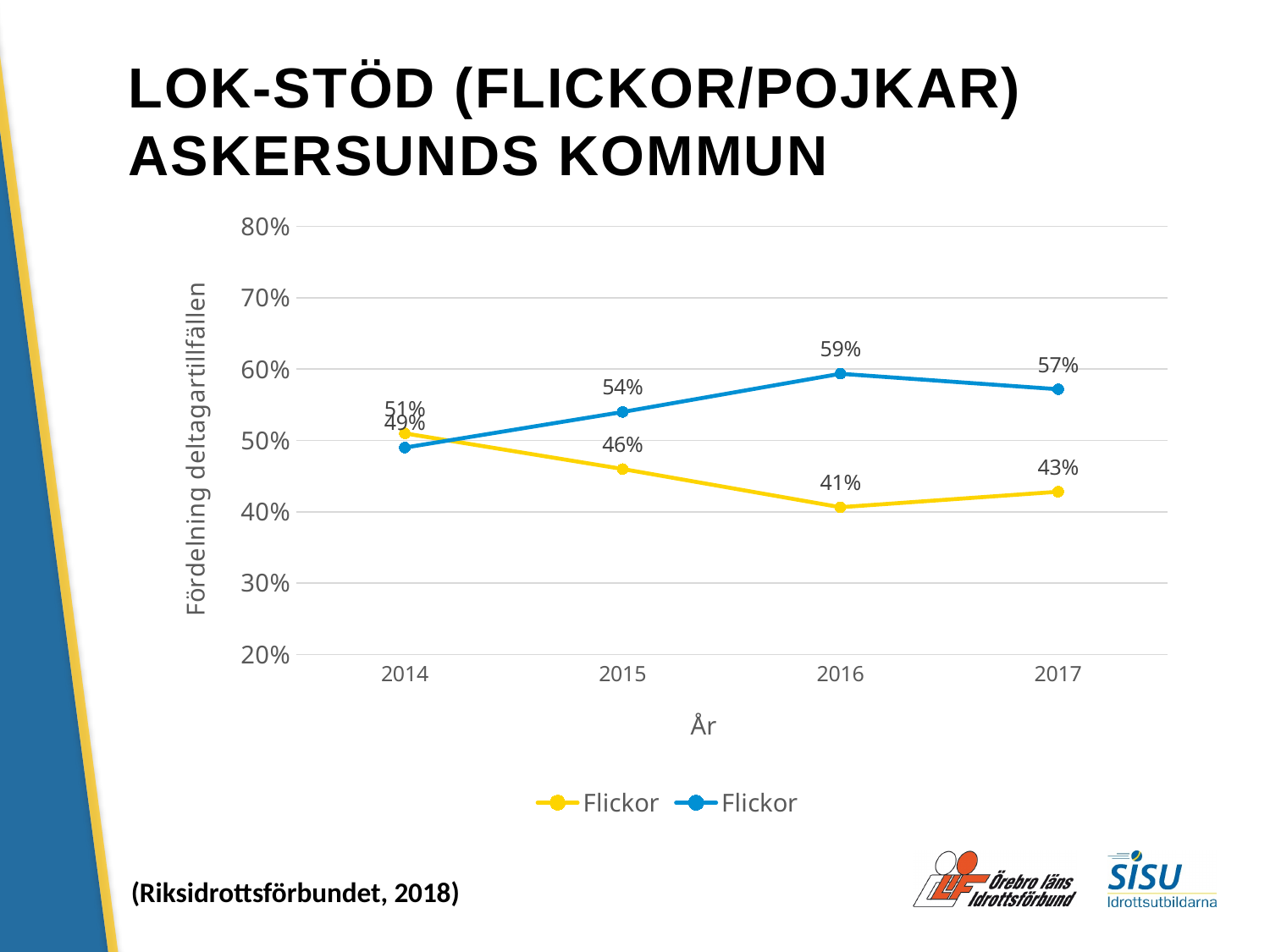
What is the value of the blue line in 2017? 57% What type of chart is shown on the slide? line chart In 2014, which line has the higher value, the yellow line or the blue line? the yellow line What is the value of the blue line in 2015? 54% How many series does the legend list? 2 What is the value of the yellow line in 2014? 51% How many years are shown on the x axis? 4 In which year does the blue line reach its highest value? 2016 What is the difference between the blue line and the yellow line in 2016? 18% What is the value of the yellow line in 2016? 41% In which year does the yellow line reach its lowest value? 2016 What is the label of the y axis? Fördelning deltagartillfällen